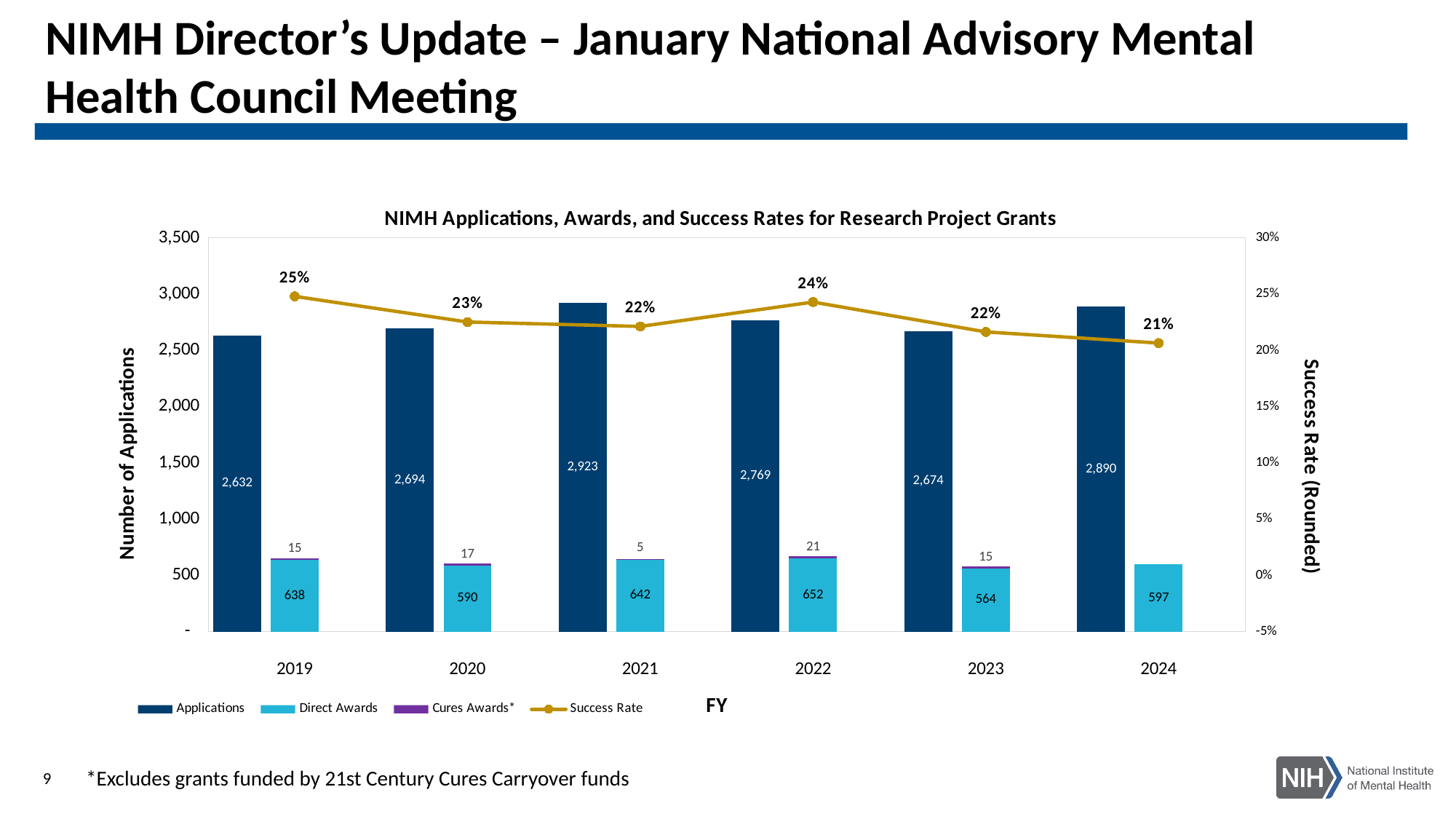
Which is larger, Direct Awards in FY 2019 or Direct Awards in FY 2020? FY 2019 Which fiscal year has the lowest Direct Awards value? 2023 What is the Success Rate shown for FY 2019? 25% What is the number of Applications in FY 2021? 2,923 What is the value of Direct Awards in FY 2023? 564 What is the difference in Applications between FY 2024 and FY 2023? 216 Which fiscal year has the lowest Success Rate? 2024 How many fiscal years are shown on the x axis? 6 What is the title of the chart? NIMH Applications, Awards, and Success Rates for Research Project Grants How many series does the legend list? 4 What is the value of Cures Awards* in FY 2022? 21 Which fiscal year has the highest number of Applications? 2021